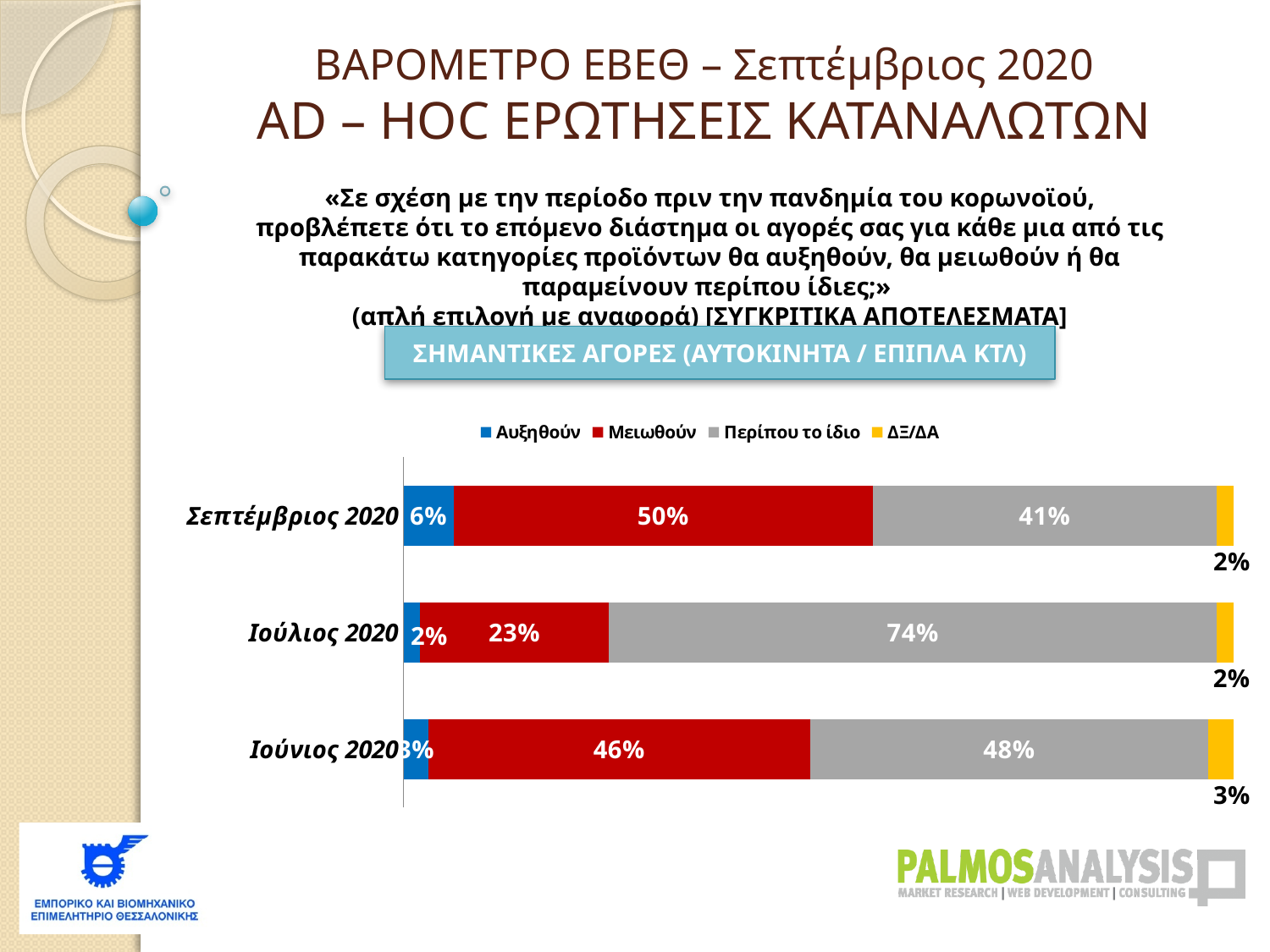
What is the value of Περίπου το ίδιο for Ιούλιος 2020? 74% How many time periods (categories) are shown in the chart? 3 Which period has the lowest value for Περίπου το ίδιο? Σεπτέμβριος 2020 What is the value of Αυξηθούν for Σεπτέμβριος 2020? 6% Which period has the highest value for Μειωθούν? Σεπτέμβριος 2020 What is the value of ΔΞ/ΔΑ for Ιούνιος 2020? 3% What is the difference between the Μειωθούν values for Σεπτέμβριος 2020 and Ιούλιος 2020? 27% Which is larger for Ιούνιος 2020: Μειωθούν or Περίπου το ίδιο? Περίπου το ίδιο How many series does the legend list? 4 What is the value of Μειωθούν for Σεπτέμβριος 2020? 50% What is the value of Μειωθούν for Ιούνιος 2020? 46% What type of chart is shown on the slide? Stacked bar chart